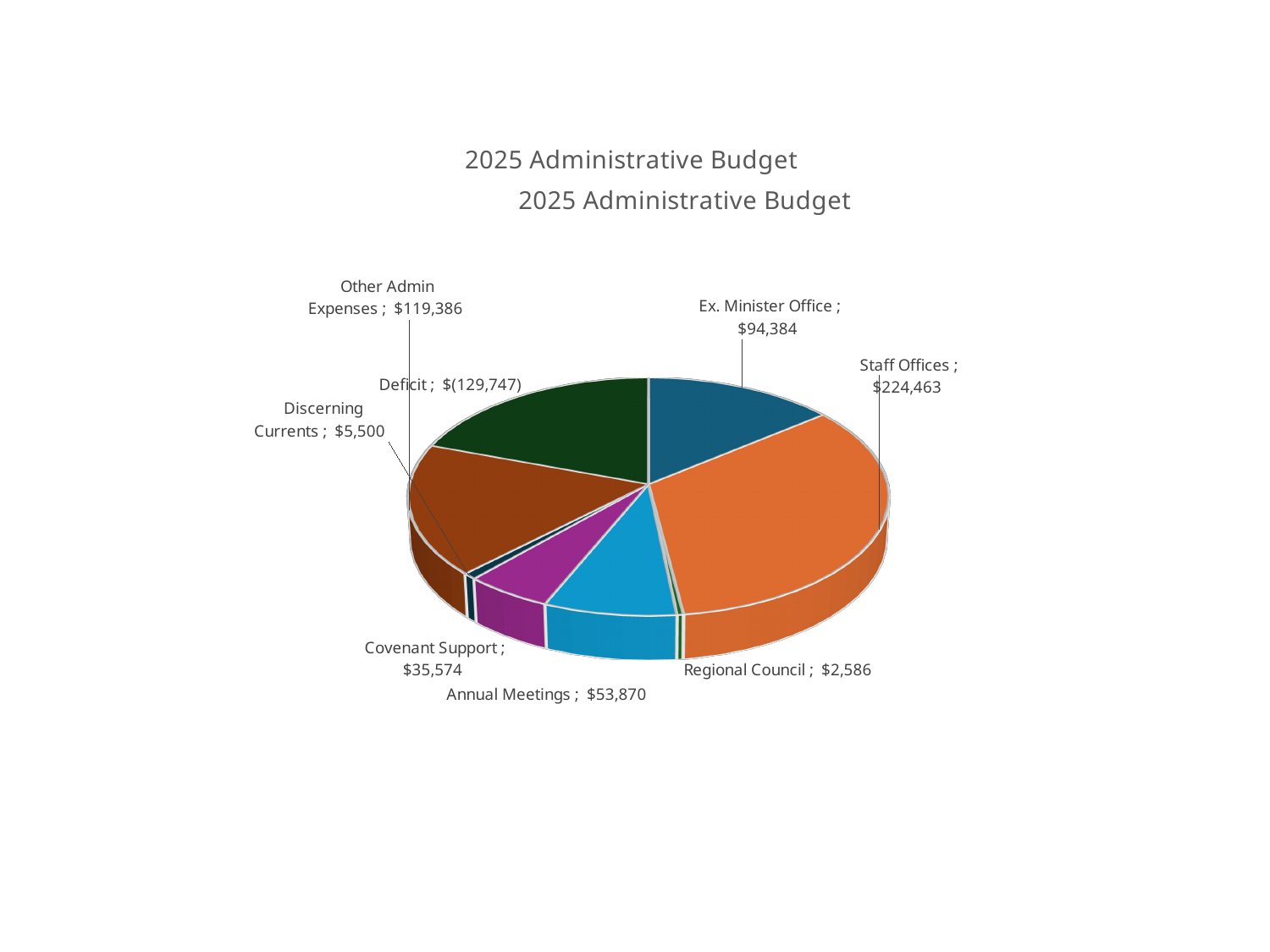
What is the value for Ex. Minister Office? $94,384 What is the difference between Staff Offices and Ex. Minister Office? $130,079 What is the value for Staff Offices? $224,463 What is the value for Discerning Currents? $5,500 Which category has the smallest slice in the pie? Regional Council What is the value for Annual Meetings? $53,870 How many categories are shown in the pie chart? 8 Which is larger, Annual Meetings or Covenant Support? Annual Meetings Which category has the largest value? Staff Offices What is the title of the chart? 2025 Administrative Budget What type of chart is shown on the slide? Pie chart What is the value shown for Deficit? $(129,747)